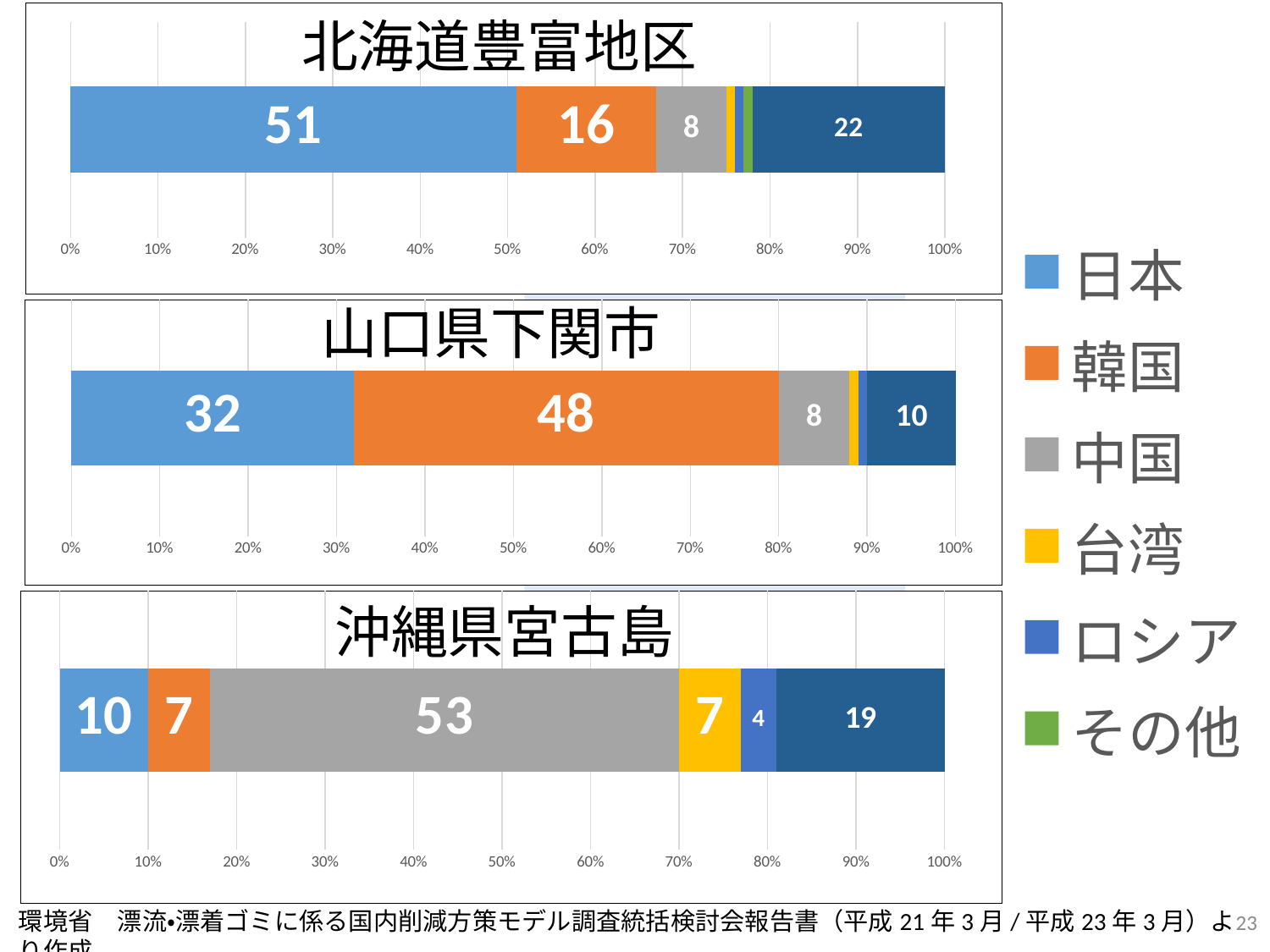
In the 北海道豊富地区 chart, what is the difference between the 日本 value and the 韓国 value? 35 In the 沖縄県宮古島 chart, what is the value for ロシア? 4 In the 北海道豊富地区 chart, what is the value for 日本? 51 In the 山口県下関市 chart, which labelled segment has the largest value? 韓国 Which legend entry is shown in yellow? 台湾 In the 山口県下関市 chart, what is the difference between the 韓国 value and the 日本 value? 16 What kind of chart is the 沖縄県宮古島 chart? Stacked bar chart In the 沖縄県宮古島 chart, what is the value for 中国? 53 How many series does the legend list? 6 In the 山口県下関市 chart, what is the value for 韓国? 48 In the 沖縄県宮古島 chart, which is larger, the value for 日本 or the value for 韓国? 日本